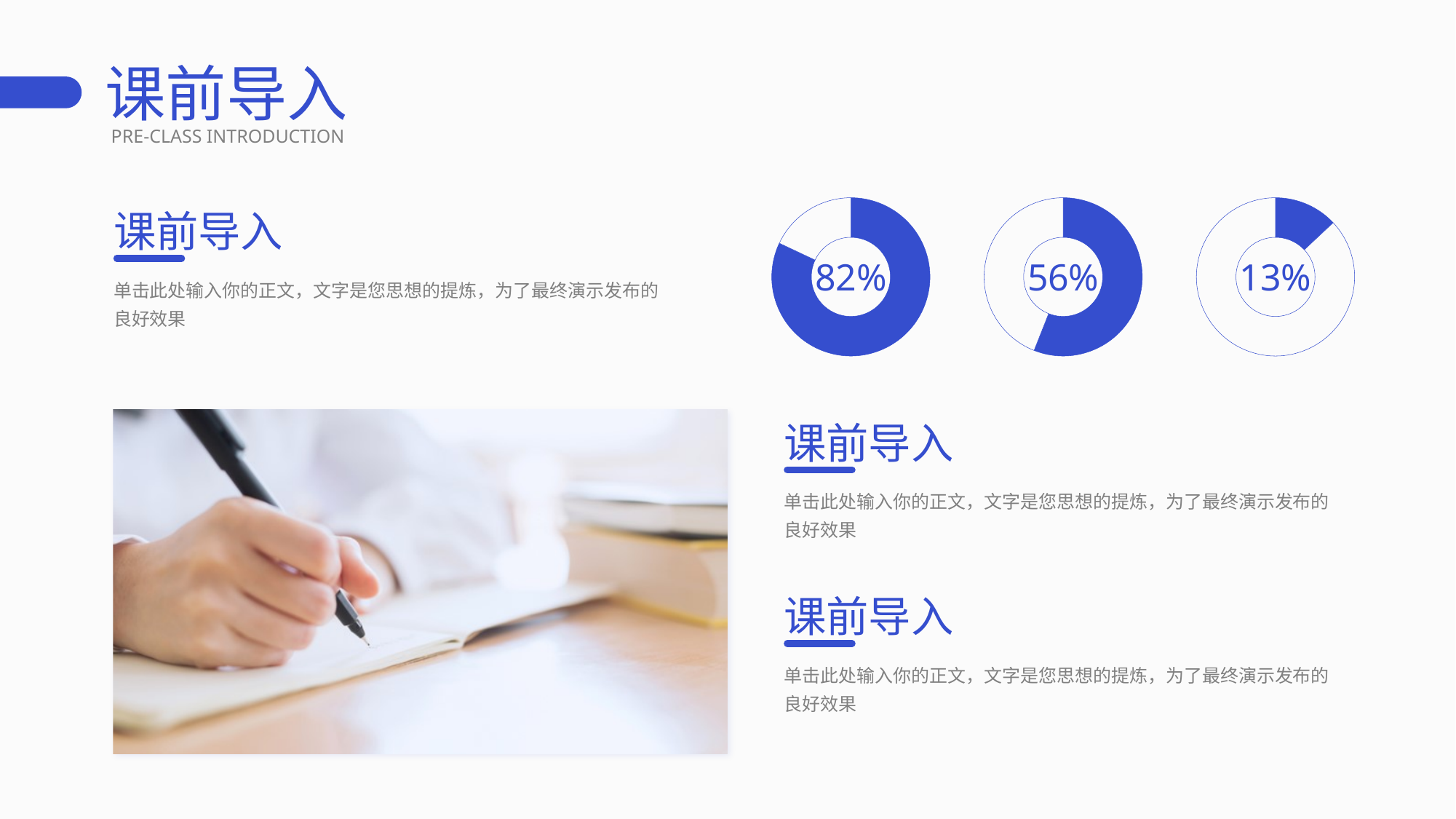
What is the difference between the value in the left donut chart and the value in the right donut chart? 69% What colour is the filled portion of the donut charts? Blue What is the difference between the value in the left donut chart and the value in the middle donut chart? 26% Which of the three donut charts shows the highest percentage? The left one (82%) How many donut charts are shown on the slide? 3 What kind of chart is used to display the percentages on the slide? Donut chart Which of the three donut charts shows the lowest percentage? The right one (13%) Which is larger, the value in the middle donut chart or the value in the right donut chart? The middle donut chart (56%) Is the value in the middle donut chart greater or less than 50%? greater What value is shown in the left donut chart? 82% What value is shown in the middle donut chart? 56% What value is shown in the right donut chart? 13%